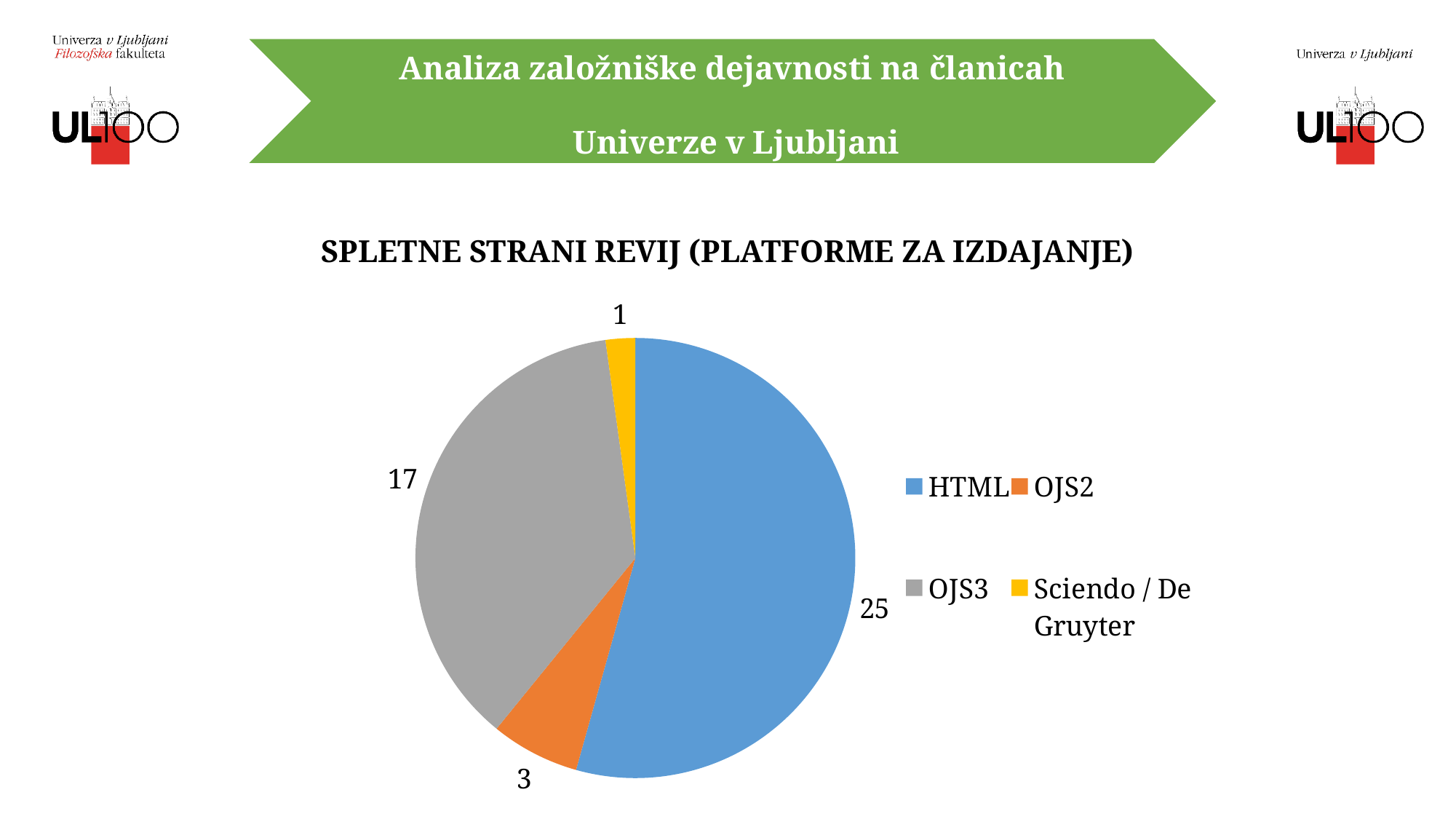
What is the difference between the values for HTML and OJS3? 8 What is the total of all slices in the pie chart? 46 What is the value for Sciendo / De Gruyter? 1 What is the title of the chart? SPLETNE STRANI REVIJ (PLATFORME ZA IZDAJANJE) What is the value for HTML? 25 Which category has the smallest slice of the pie? Sciendo / De Gruyter What is the value for OJS2? 3 Which category has the largest slice of the pie? HTML How many categories does the pie chart have? 4 What is the value for OJS3? 17 Which is larger, the value for OJS2 or the value for OJS3? OJS3 What type of chart is shown on the slide? Pie chart